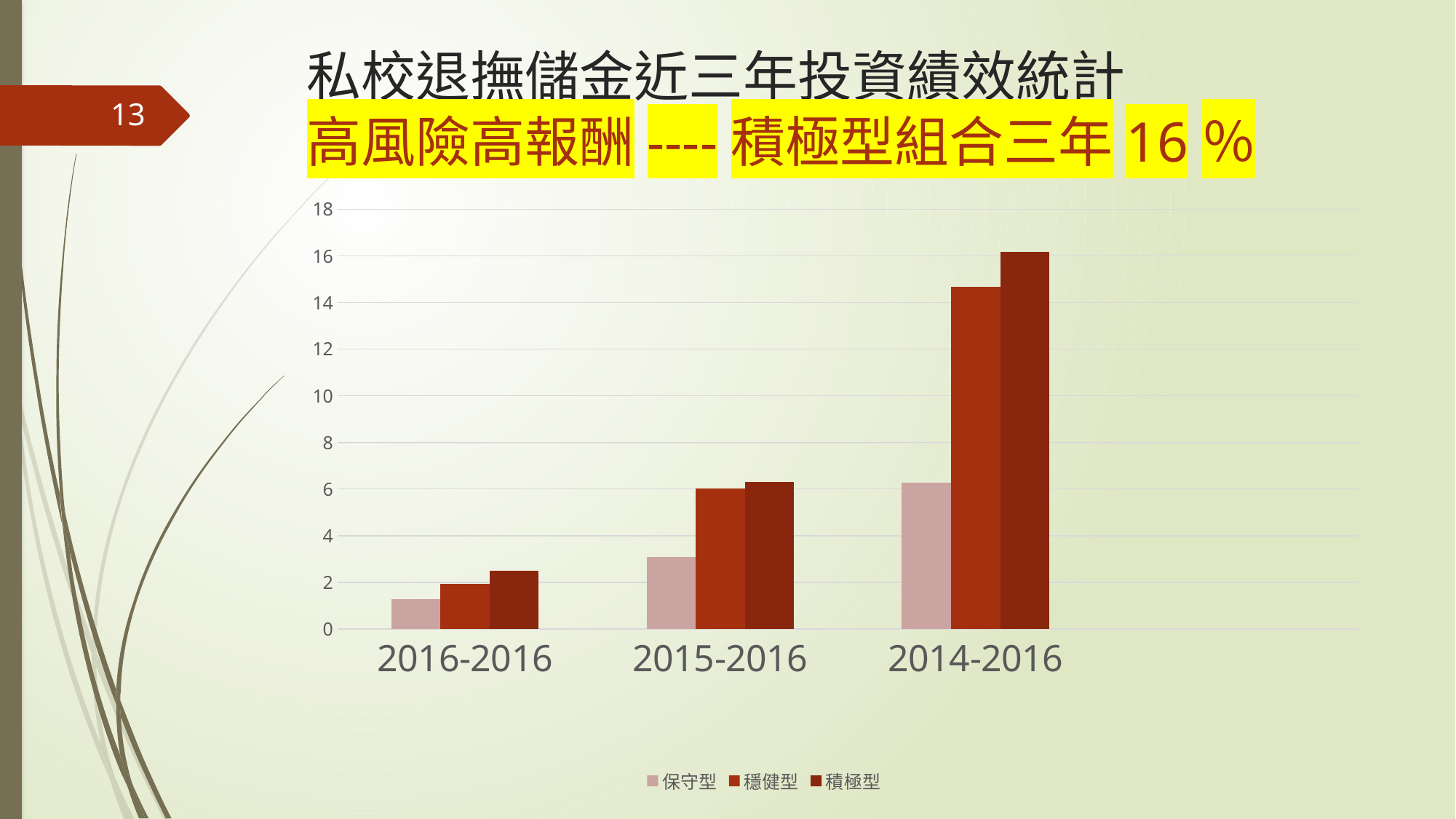
Which category has the lowest bar for 保守型? 2016-2016 In the 2015-2016 group, which is larger: 穩健型 or 保守型? 穩健型 What are the three series names listed in the legend? 保守型, 穩健型, 積極型 Do the 保守型 values rise or fall moving from 2016-2016 to 2014-2016 along the x axis? rise In the 2014-2016 group, which is larger: 穩健型 or 保守型? 穩健型 Is the value for 穩健型 in 2014-2016 greater or less than 12? greater How many series does the legend list? 3 Which series has the highest bar in the 2014-2016 group? 積極型 How many categories are shown on the x axis? 3 Is the value for 積極型 in 2014-2016 greater or less than 14? greater Is the value for 保守型 in 2016-2016 greater or less than 2? less What kind of chart is shown on the slide? bar chart